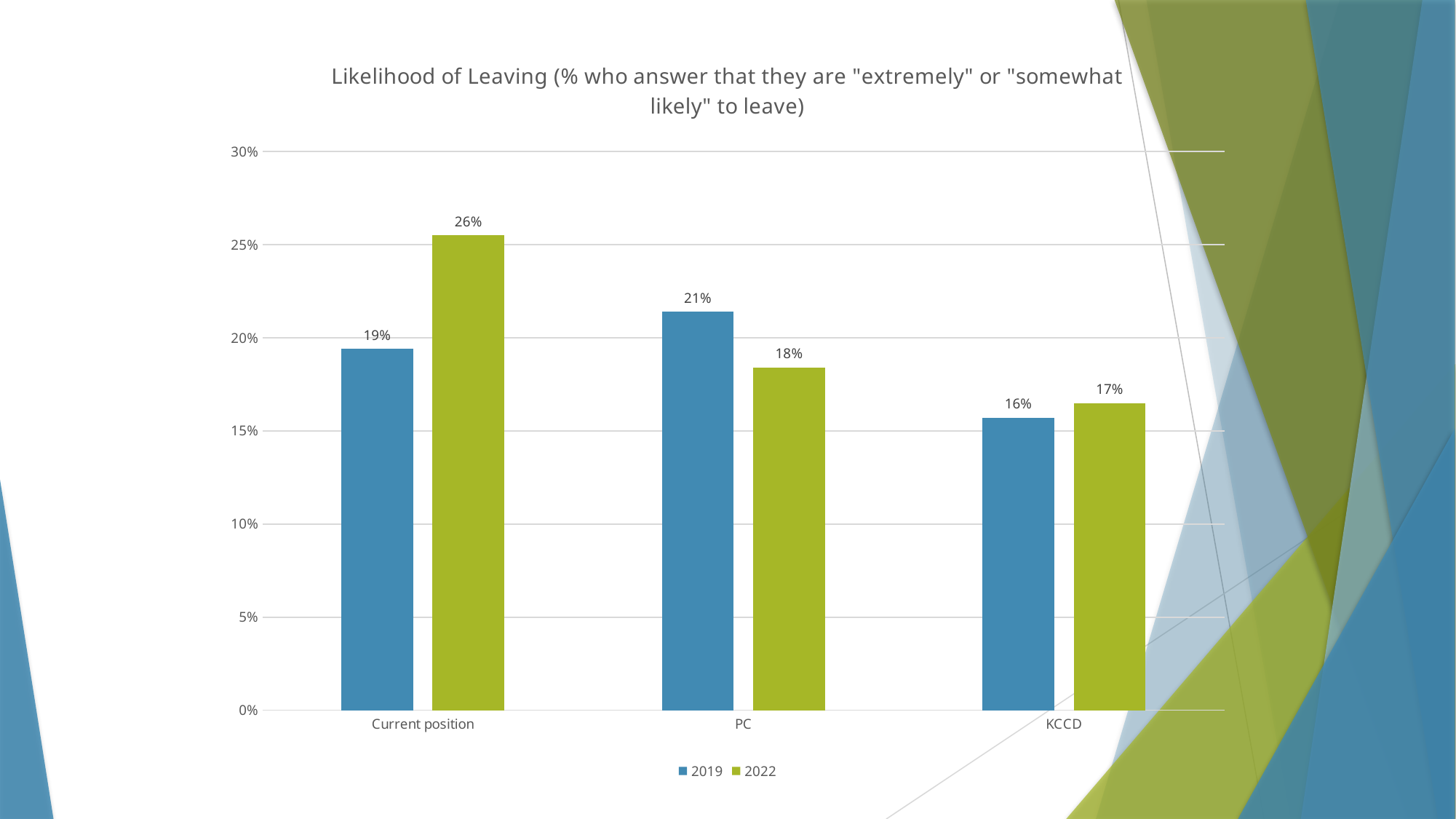
How many categories are shown on the x axis? 3 What is the 2022 value for Current position? 26% How many series does the legend list? 2 What kind of chart is shown on the slide? Bar chart What is the 2022 value for PC? 18% What is the 2019 value for PC? 21% Which series is shown in green? 2022 For PC, which series has the larger value, 2019 or 2022? 2019 What is the 2019 value for KCCD? 16% Which category has the lowest 2019 value? KCCD Which category has the highest 2022 value? Current position What is the difference between the 2022 and 2019 values for Current position? 7%